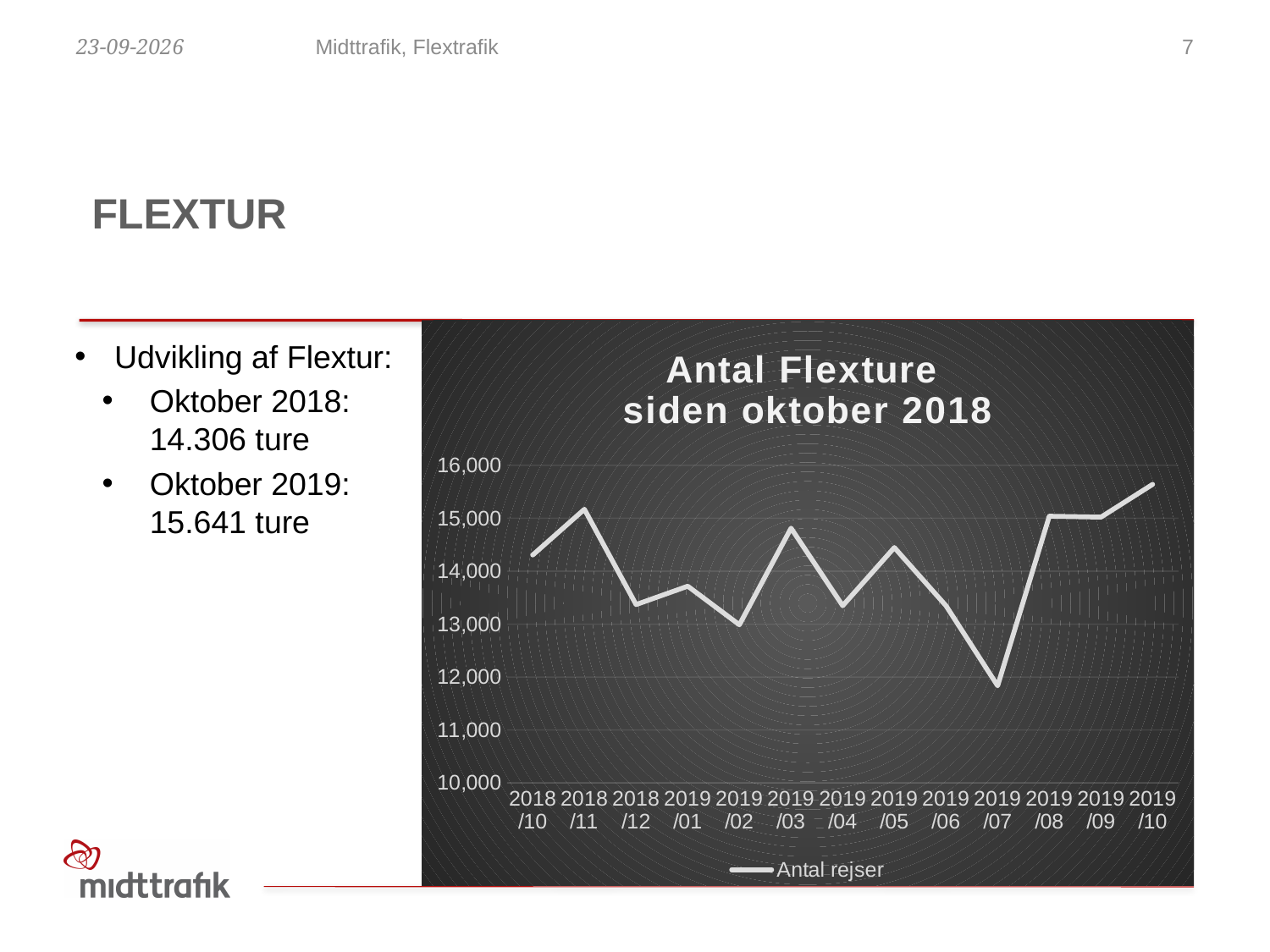
Which month has the highest number of Flexture in the chart? 2019/10 What type of chart is shown on the slide? line chart Which is larger, the value for 2019/03 or the value for 2019/04? 2019/03 Is the value for 2019/03 greater or less than 14,000? greater Is the value for 2019/07 greater or less than 12,000? less Do the values rise or fall from 2019/07 to 2019/10? rise How many series does the chart legend list? 1 What is the title of the chart? Antal Flexture siden oktober 2018 Is the value for 2019/06 greater or less than 14,000? less How many months (data points) are plotted on the x axis of the chart? 13 What is the name of the series shown in the chart legend? Antal rejser Which month has the lowest number of Flexture in the chart? 2019/07